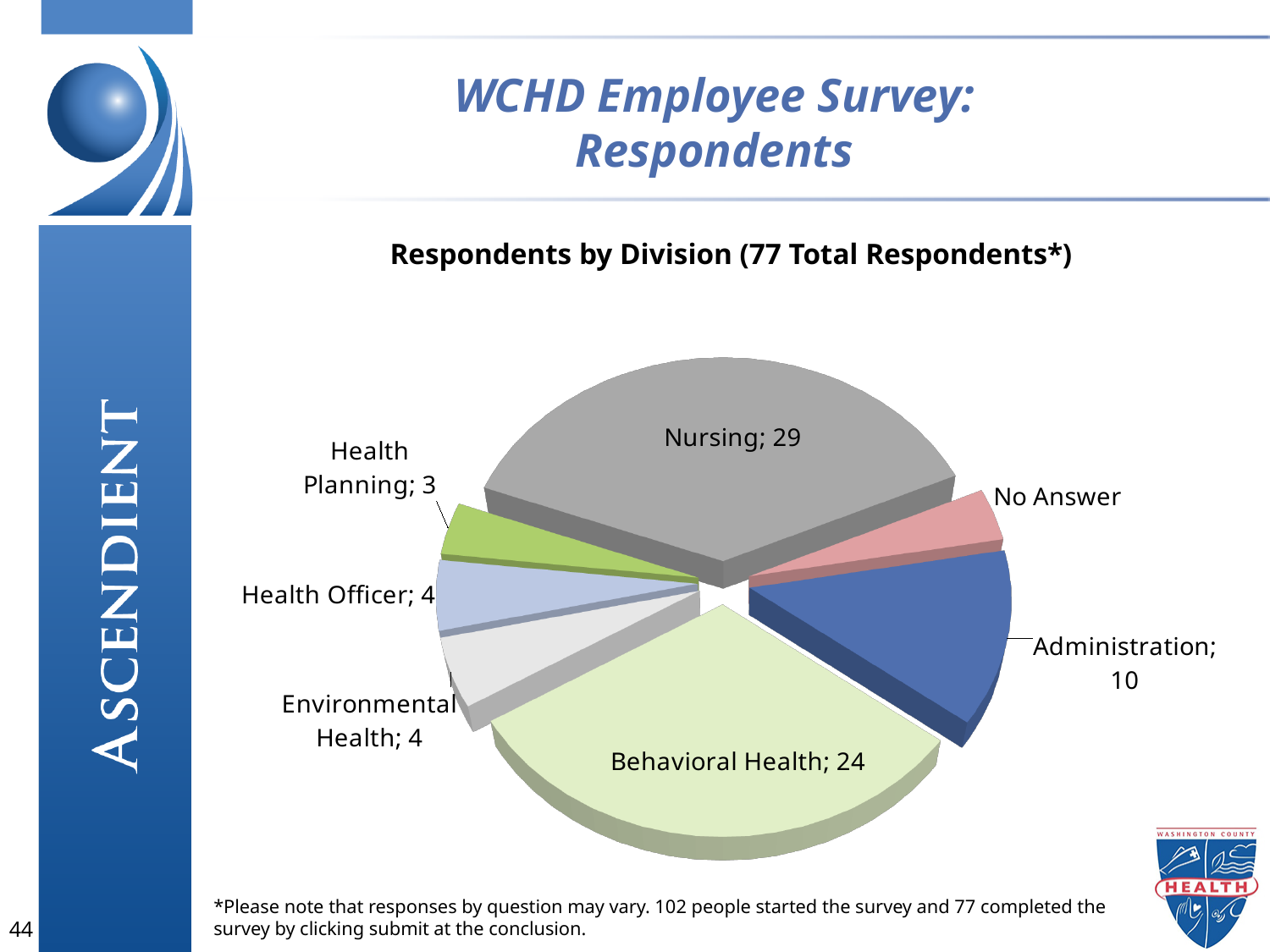
How many respondents are in the Health Planning division? 3 What kind of chart is shown on the slide? pie chart Which division has the largest number of respondents? Nursing How many respondents are in the Administration division? 10 How many slices does the pie chart have? 7 What is the title of the chart? Respondents by Division (77 Total Respondents*) What is the difference between the Administration and Health Officer respondent counts? 6 Which has more respondents, Behavioral Health or Administration? Behavioral Health What is the difference between the Nursing and Behavioral Health respondent counts? 5 How many respondents are in the Nursing division? 29 How many respondents are in the Environmental Health division? 4 How many respondents are in the Behavioral Health division? 24